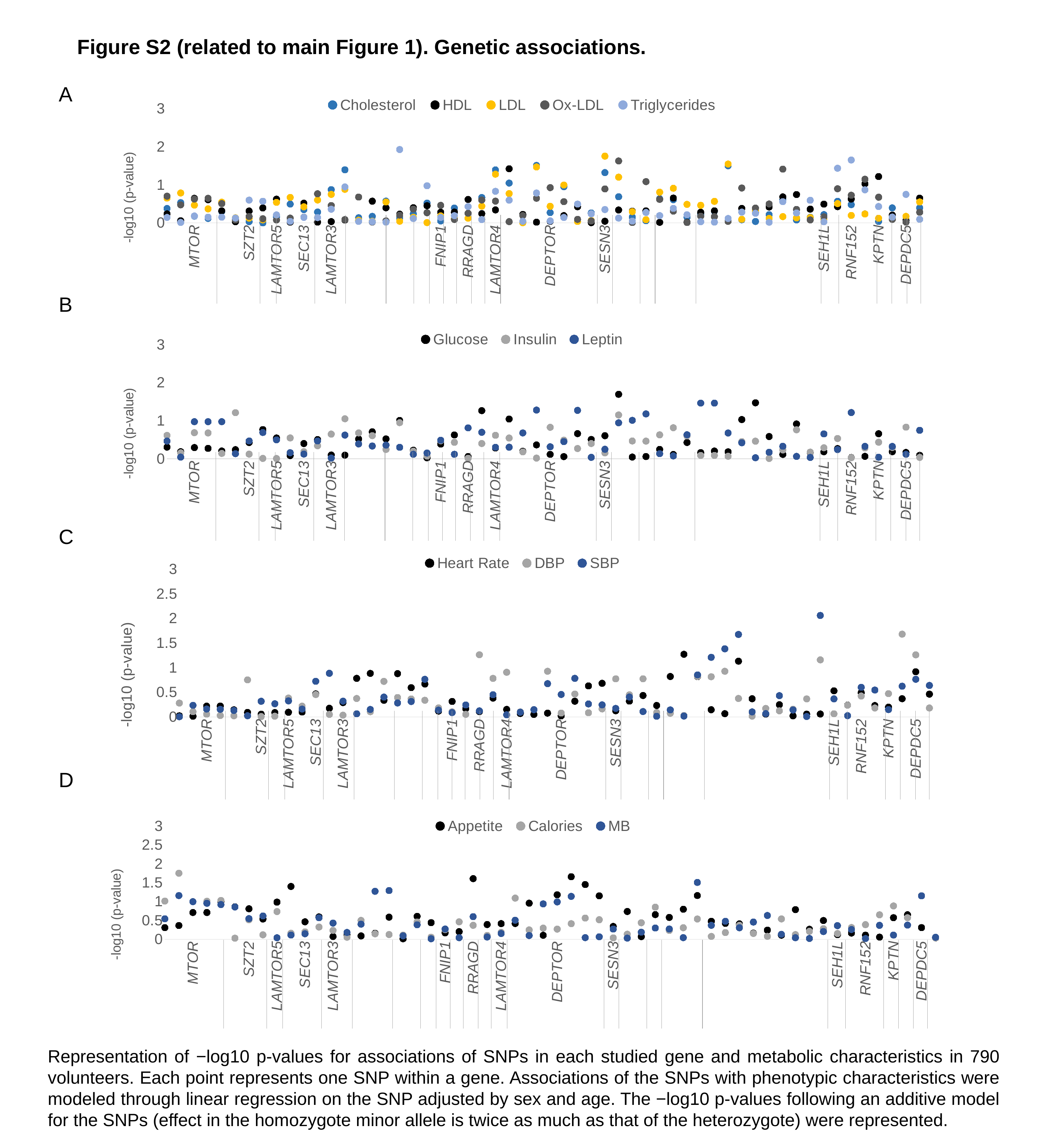
How many series does the legend of chart C list? 3 In chart A, is the highest Triglycerides value greater or less than 1.5? greater How many charts are shown on the slide? 4 In chart C, which series has the highest plotted point? SBP What kind of chart is chart A? scatter chart Which series are listed in the legend of chart D? Appetite, Calories, MB In chart C, is the highest SBP value greater or less than 1.5? greater In chart B, which series has the highest plotted point? Glucose What is the y-axis label of chart B? -log10 (p-value) In chart D, is the highest Calories value greater or less than 1.5? greater How many series does the legend of chart A list? 5 How many series does the legend of chart B list? 3